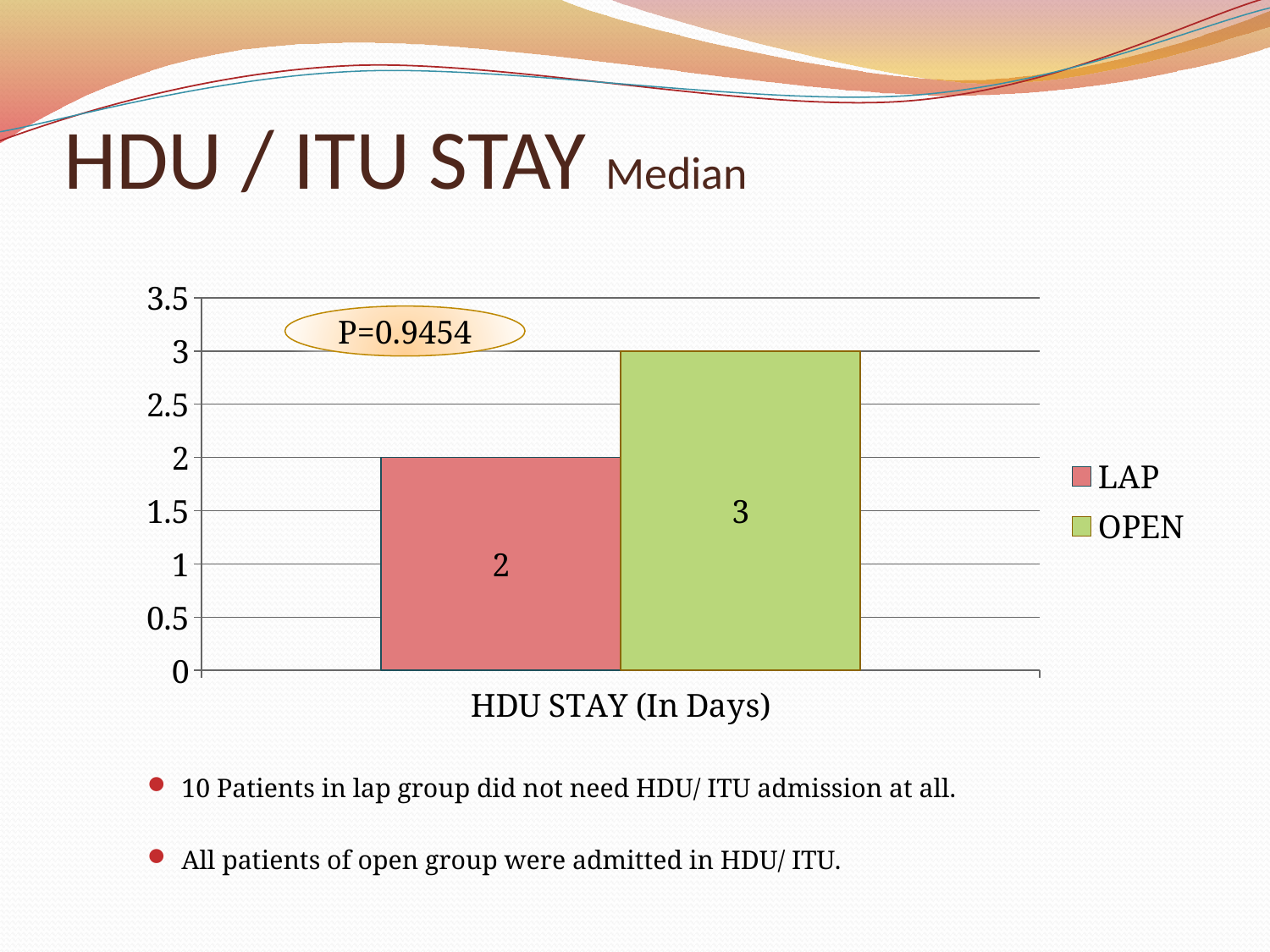
How many series does the legend list? 2 What is the label on the x axis of the chart? HDU STAY (In Days) What kind of chart is shown on the slide? Bar chart What is the median HDU stay in days for the OPEN group? 3 What is the median HDU stay in days for the LAP group? 2 Which group has the lower median HDU stay? LAP Is the median HDU stay larger for LAP or OPEN? OPEN What P value is shown on the chart? P=0.9454 Which group has the higher median HDU stay? OPEN What is the maximum value shown on the y axis? 3.5 Is the value for OPEN greater or less than 2.5? greater What is the difference in median HDU stay between the OPEN and LAP groups? 1